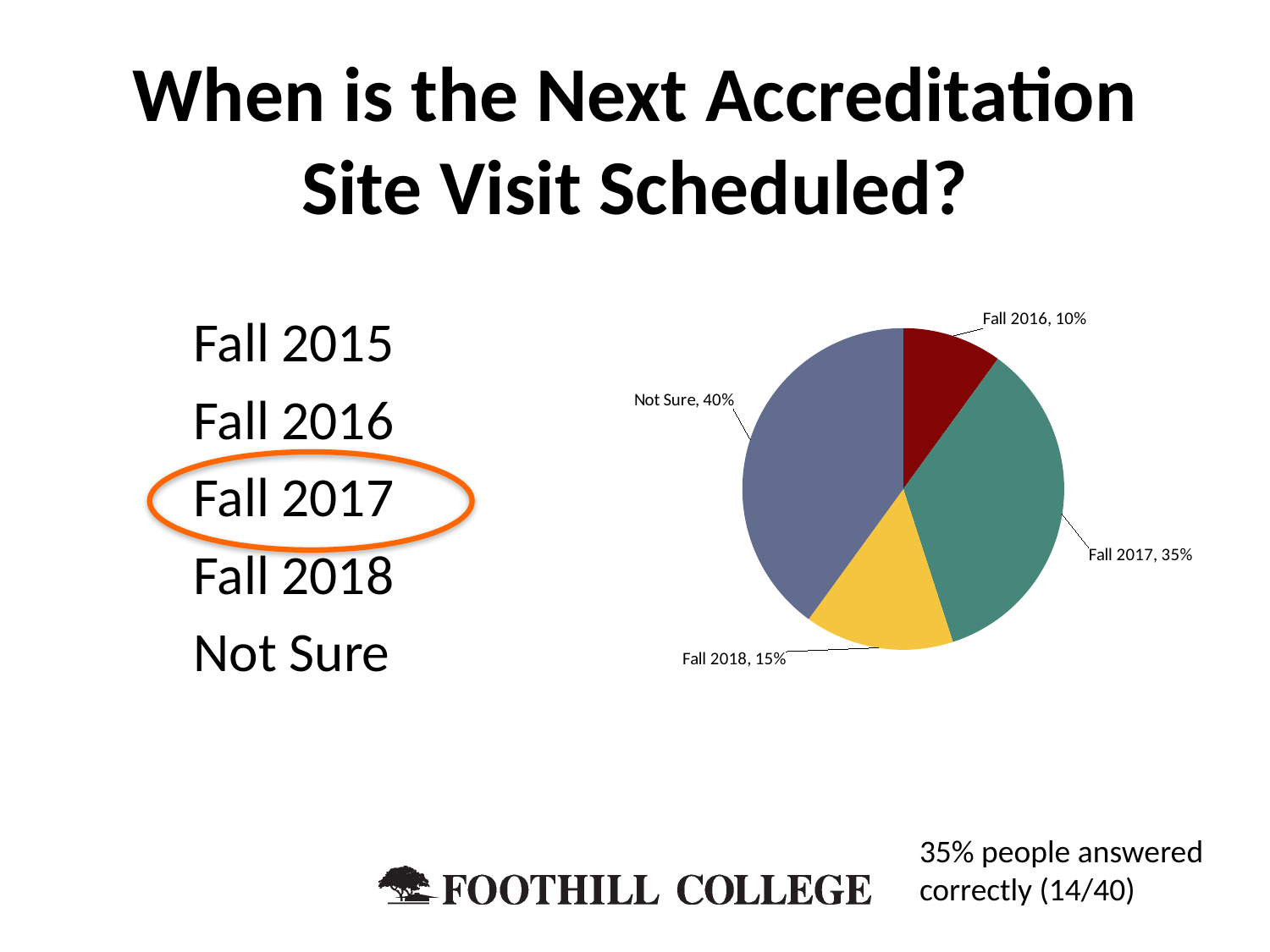
Which slice of the pie chart is the smallest? Fall 2016 What colour is the Fall 2018 slice of the pie chart? yellow What is the difference between the Not Sure share and the Fall 2017 share? 5% What share of the pie does Not Sure have? 40% Which is larger, the Fall 2017 slice or the Fall 2018 slice? Fall 2017 What share of the pie does Fall 2016 have? 10% How many slices does the pie chart have? 4 What kind of chart is shown on the slide? pie chart What is the difference between the Fall 2018 share and the Fall 2016 share? 5% What share of the pie does Fall 2017 have? 35% Which slice of the pie chart is the largest? Not Sure